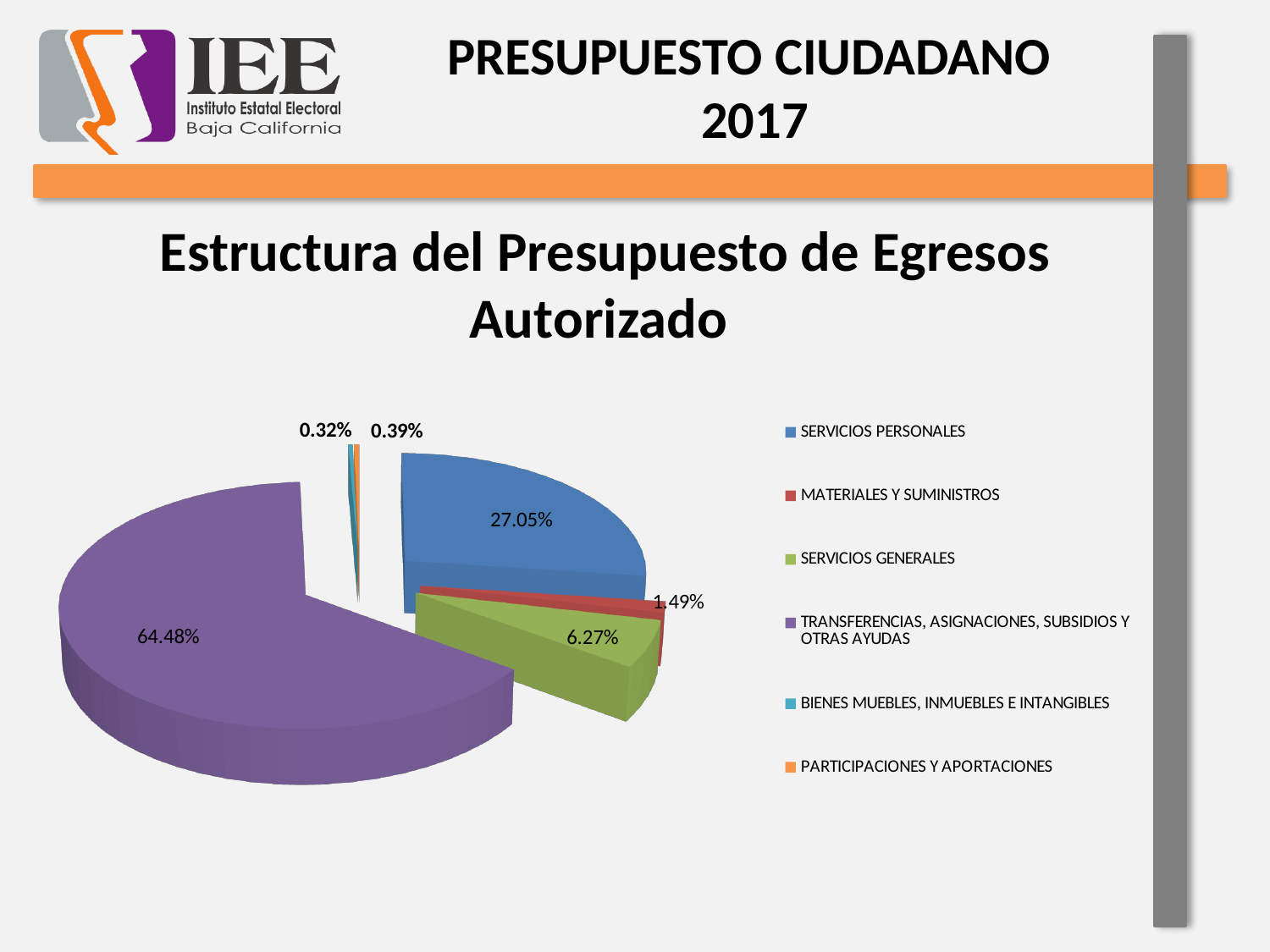
What share of the pie does TRANSFERENCIAS, ASIGNACIONES, SUBSIDIOS Y OTRAS AYUDAS represent? 64.48% Which category has the smallest slice of the pie? BIENES MUEBLES, INMUEBLES E INTANGIBLES Which is larger, the slice for SERVICIOS GENERALES or the slice for MATERIALES Y SUMINISTROS? SERVICIOS GENERALES Which category has the largest slice of the pie? TRANSFERENCIAS, ASIGNACIONES, SUBSIDIOS Y OTRAS AYUDAS What share of the pie does BIENES MUEBLES, INMUEBLES E INTANGIBLES represent? 0.32% What share of the pie does SERVICIOS GENERALES represent? 6.27% What kind of chart is shown on the slide? pie chart What share of the pie does SERVICIOS PERSONALES represent? 27.05% What share of the pie does PARTICIPACIONES Y APORTACIONES represent? 0.39% What share of the pie does MATERIALES Y SUMINISTROS represent? 1.49% What is the difference in percentage points between TRANSFERENCIAS, ASIGNACIONES, SUBSIDIOS Y OTRAS AYUDAS and SERVICIOS PERSONALES? 37.43 How many categories does the legend list? 6